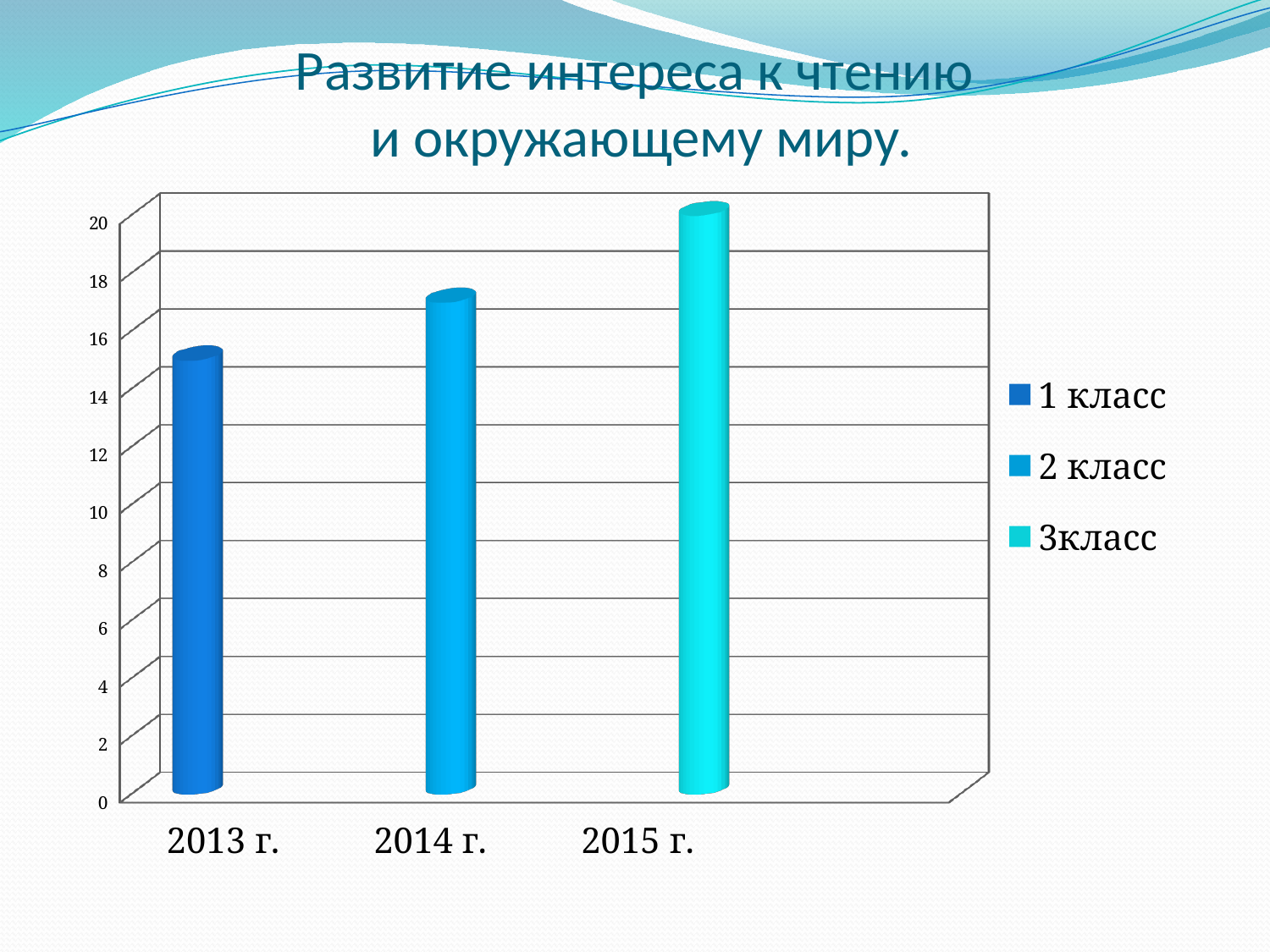
What kind of chart is shown on the slide? bar chart What are the three legend entries of the chart? 1 класс, 2 класс, 3класс How many series does the chart's legend list? 3 How many categories are shown on the x axis of the chart? 3 Is the value for 2015 г. greater or less than 18? greater Which year has the lowest bar in the chart? 2013 г. Which bar is taller, 2013 г. or 2014 г.? 2014 г. Which year has the highest bar in the chart? 2015 г. Is the value for 2013 г. greater or less than 16? less Is the value for 2014 г. greater or less than 16? greater Do the bar values rise or fall from 2013 г. to 2015 г.? rise